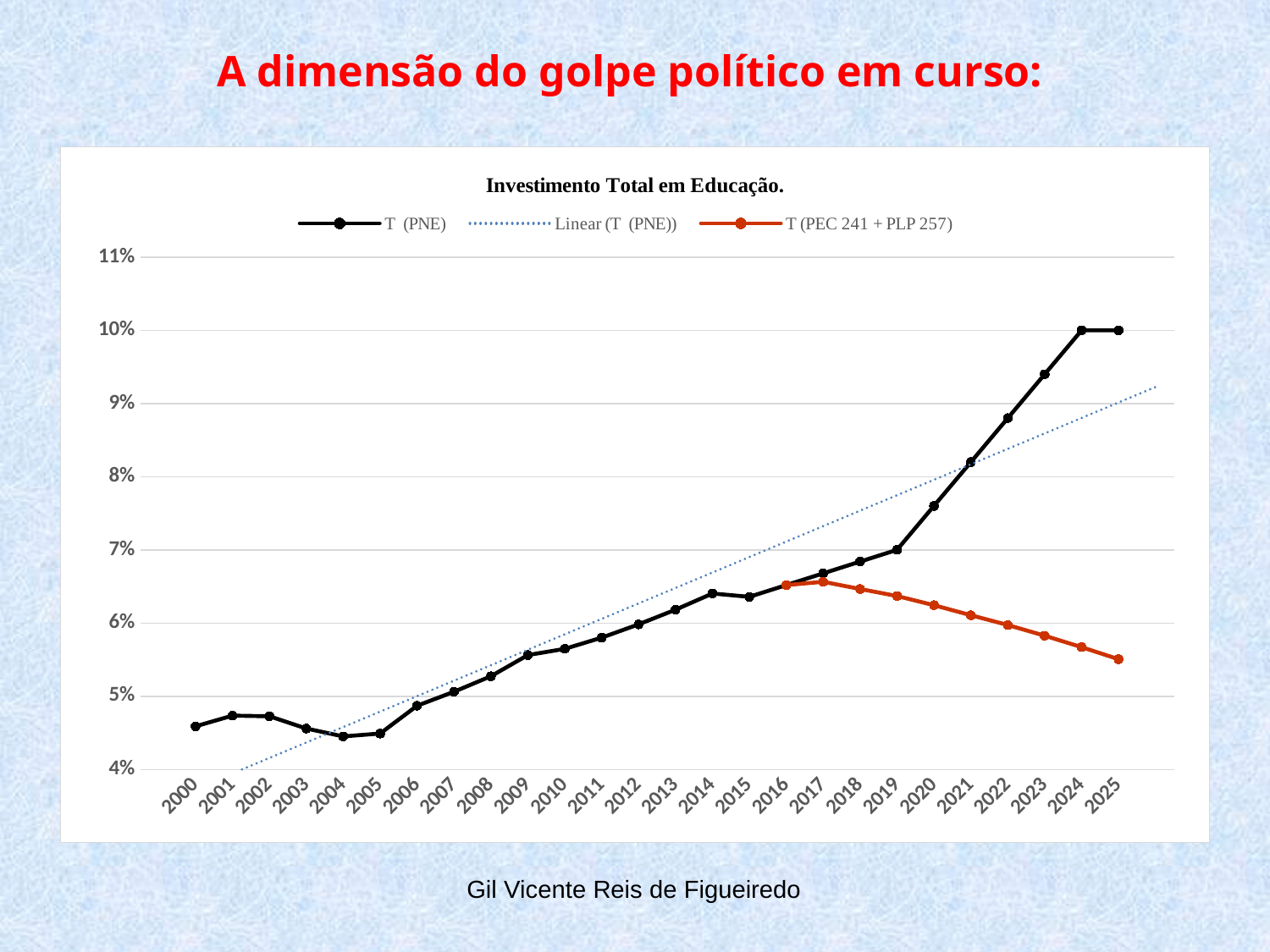
How many years are shown on the x axis of the chart? 26 What type of chart is shown on the slide? line chart In 2025, which series has the larger value, T (PNE) or T (PEC 241 + PLP 257)? T (PNE) Is the value of T (PNE) in 2000 greater or less than 5%? less Is the value of T (PEC 241 + PLP 257) in 2025 greater or less than 6%? less What is the value of T (PNE) in 2025? 10% What is the title of the chart? Investimento Total em Educação. What is the highest value reached by the T (PNE) series? 10% Does the T (PEC 241 + PLP 257) series rise or fall from 2017 to 2025? fall Is the value of T (PNE) in 2020 greater or less than 7%? greater What colour is the line for T (PEC 241 + PLP 257)? orange How many series does the chart legend list? 3